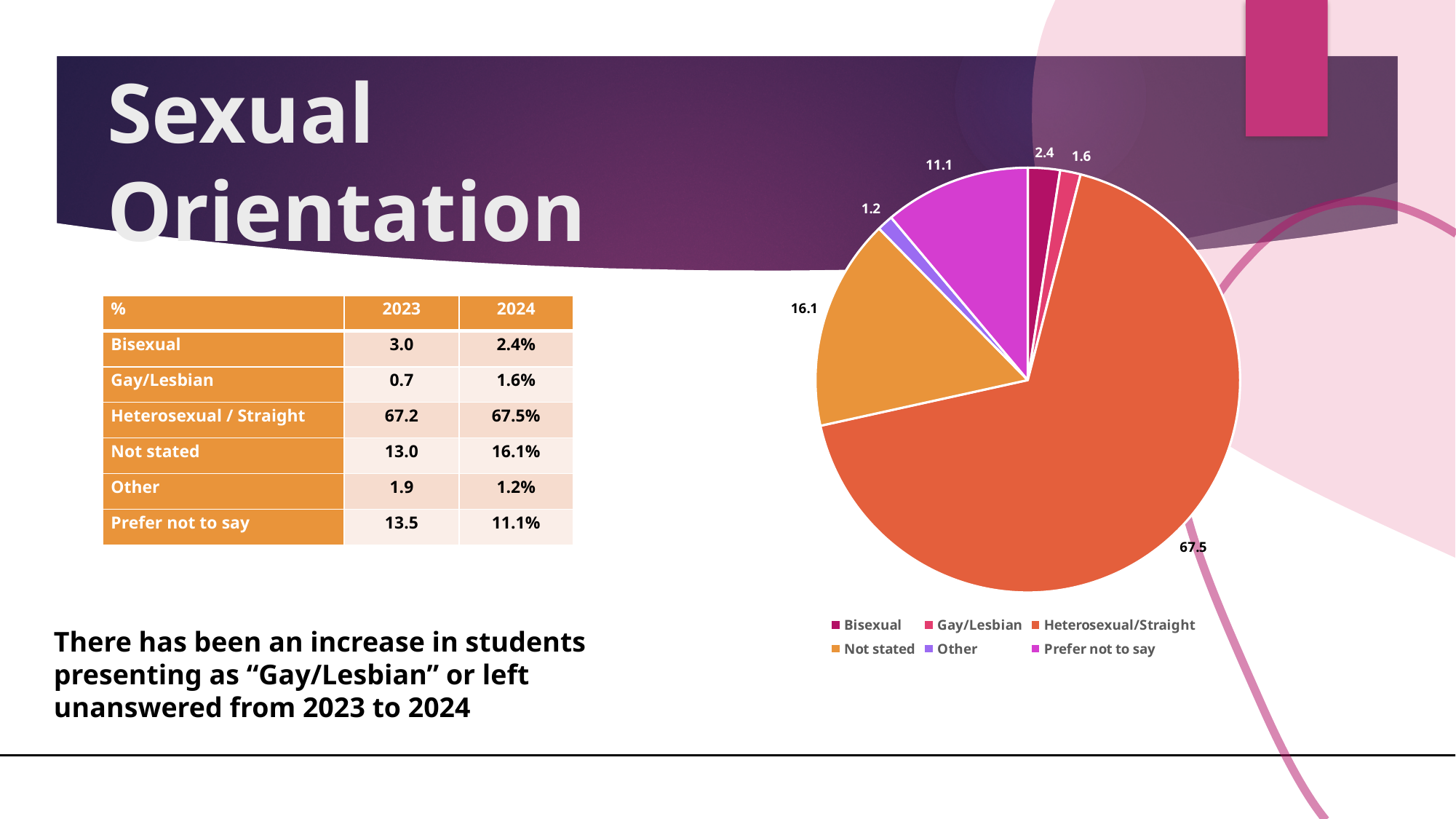
What is the value of the Not stated slice in the pie chart? 16.1 Which category has the largest slice in the pie chart? Heterosexual/Straight Which is larger in the pie chart, Bisexual or Gay/Lesbian? Bisexual What is the value of the Prefer not to say slice in the pie chart? 11.1 What is the value of the Heterosexual/Straight slice in the pie chart? 67.5 Which category has the smallest slice in the pie chart? Other What colour is the Heterosexual/Straight slice in the pie chart? orange What is the difference between the Not stated and Prefer not to say values in the pie chart? 5.0 How many slices does the pie chart have? 6 What is the value of the Bisexual slice in the pie chart? 2.4 What kind of chart is shown on the slide? pie chart What is the value of the Gay/Lesbian slice in the pie chart? 1.6